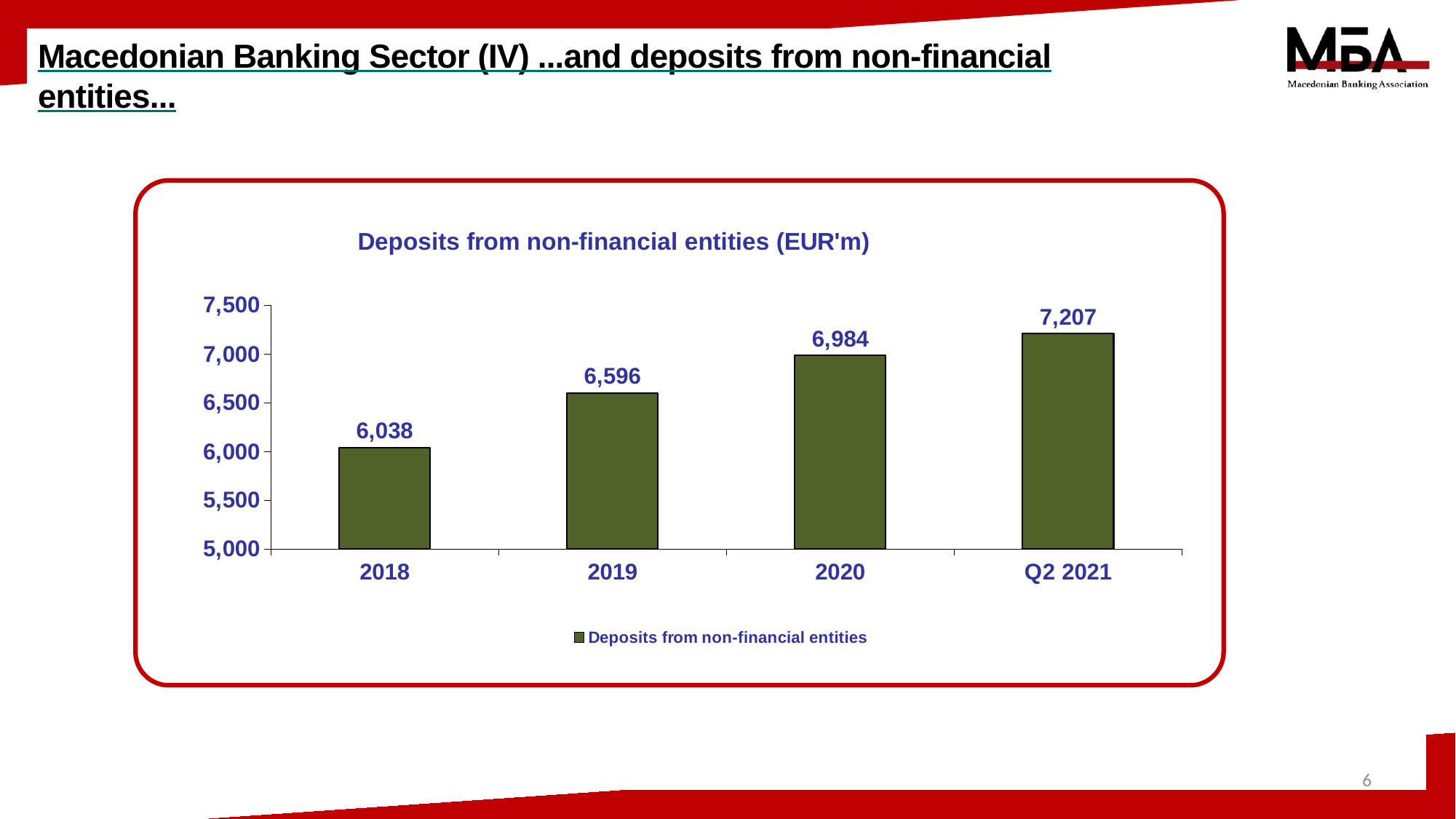
What is the value of deposits from non-financial entities in 2020? 6,984 What is the difference between deposits from non-financial entities in Q2 2021 and 2018? 1,169 Which is larger, deposits from non-financial entities in 2019 or in 2020? 2020 Which period has the lowest value of deposits from non-financial entities? 2018 Do deposits from non-financial entities rise or fall from 2018 to Q2 2021? Rise What is the value of deposits from non-financial entities in 2019? 6,596 What is the difference between deposits from non-financial entities in 2020 and 2019? 388 Which period has the highest value of deposits from non-financial entities? Q2 2021 What is the value of deposits from non-financial entities in 2018? 6,038 How many periods are shown on the x axis of the chart? 4 What kind of chart is shown on the slide? Bar chart What is the value of deposits from non-financial entities in Q2 2021? 7,207